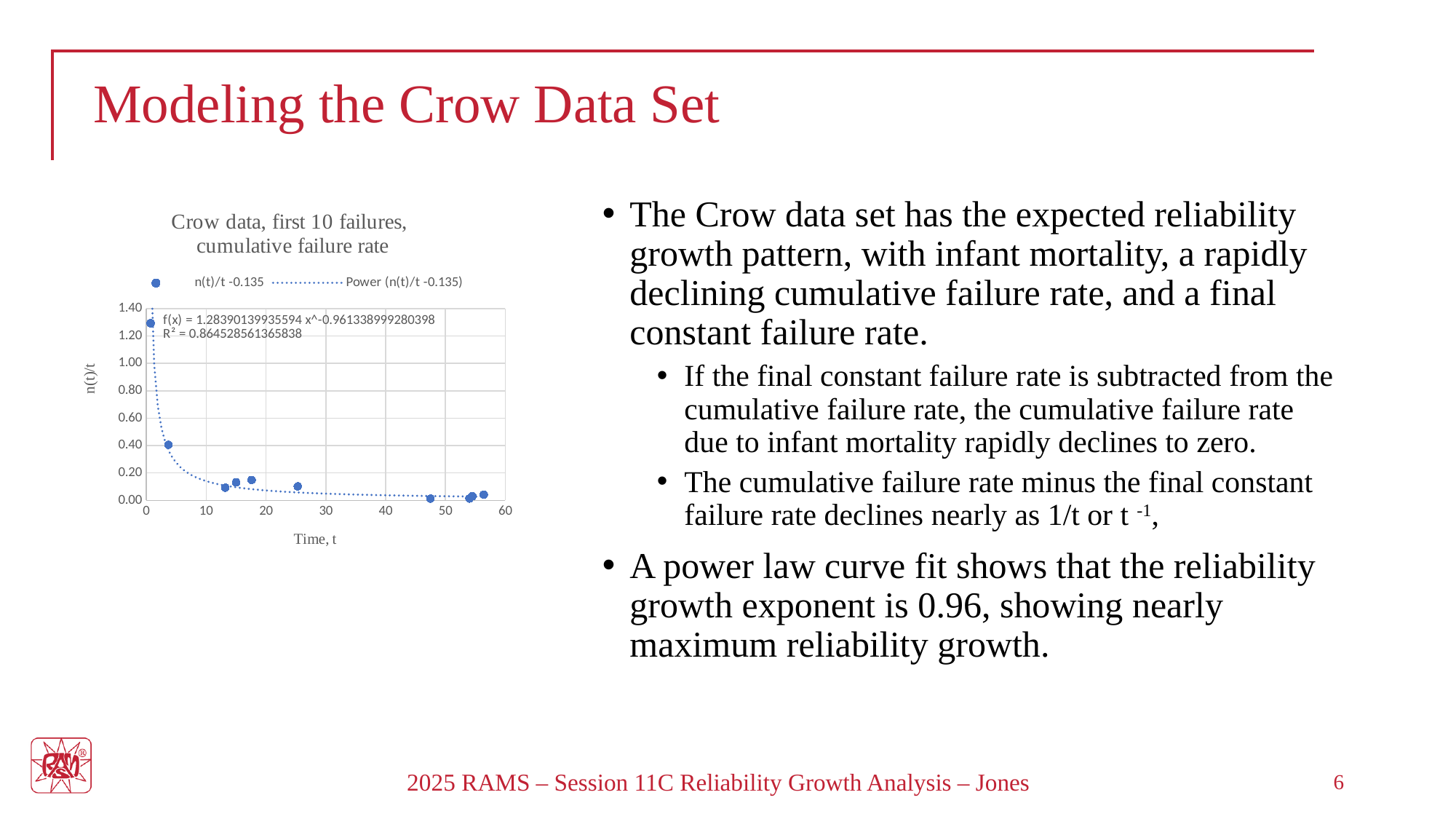
Do the plotted n(t)/t values rise or fall as Time, t increases? Fall Does the highest n(t)/t value occur at the smallest or the largest time value? Smallest Which is larger: the n(t)/t value of the point near t = 1 or the point near t = 55? The point near t = 1 What is the R² value shown for the power trendline on the chart? 0.864528561365838 How many data points are plotted in the chart? 10 Is the value of the first plotted point (near t = 1) greater or less than 1.00? greater How many series does the chart legend list? 2 Is the value of the plotted point near t = 47 greater or less than 0.20? less What is the label of the x axis of the chart? Time, t What is the title of the chart? Crow data, first 10 failures, cumulative failure rate What kind of chart is shown on the slide? Scatter chart Is the value of the plotted point near t = 25 greater or less than 0.20? less